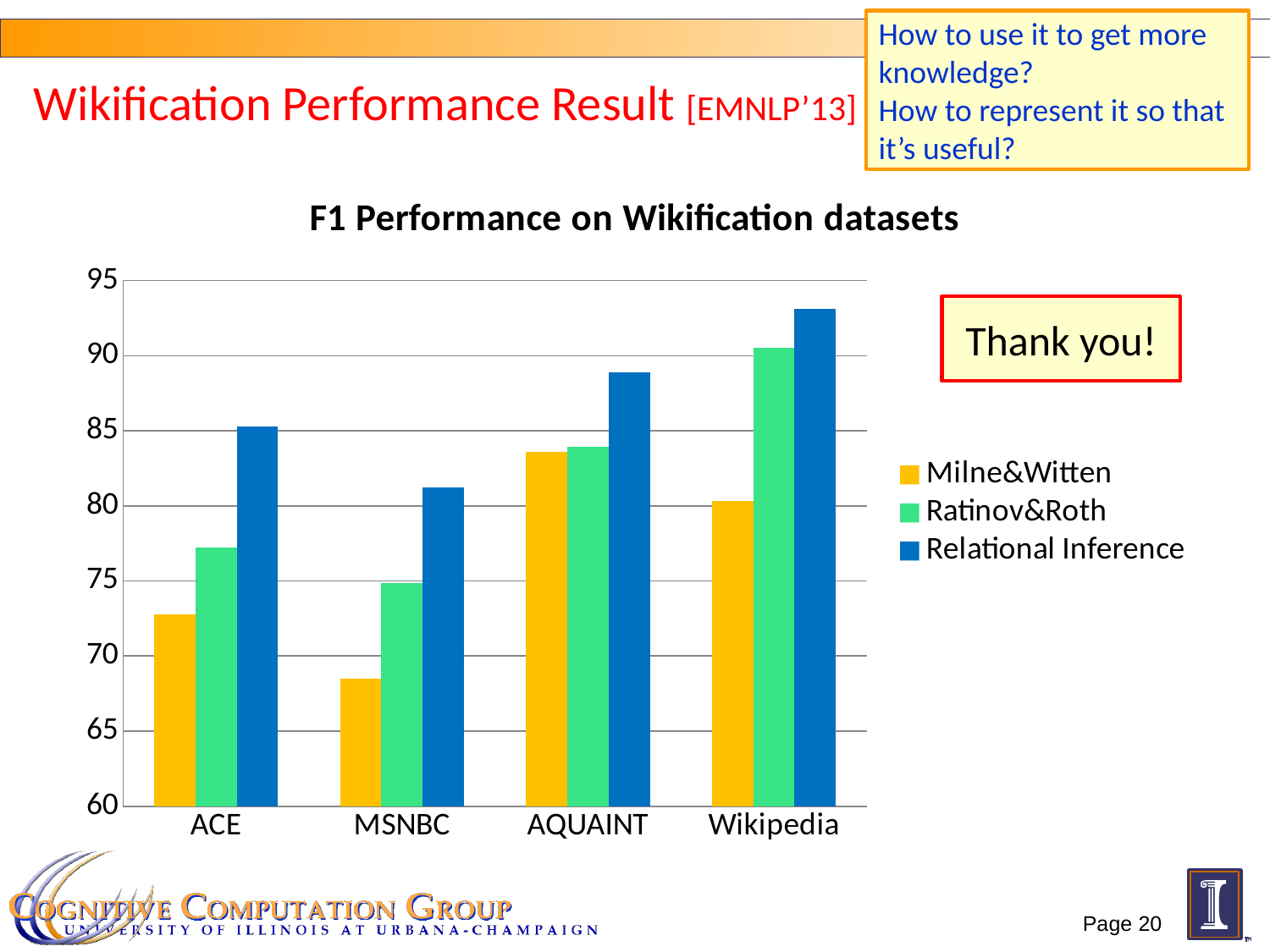
How many datasets (categories) are shown on the x axis? 4 For ACE, which is larger: the Ratinov&Roth value or the Relational Inference value? Relational Inference Is the Relational Inference value for Wikipedia greater or less than 90? greater What kind of chart is shown on the slide? bar chart Is the Ratinov&Roth value for Wikipedia greater or less than 85? greater Is the Milne&Witten value for AQUAINT greater or less than 80? greater Which dataset has the lowest Milne&Witten bar? MSNBC What is the title of the chart? F1 Performance on Wikification datasets Which series is shown in blue in the legend? Relational Inference How many series does the legend list? 3 Which dataset has the highest Relational Inference bar? Wikipedia